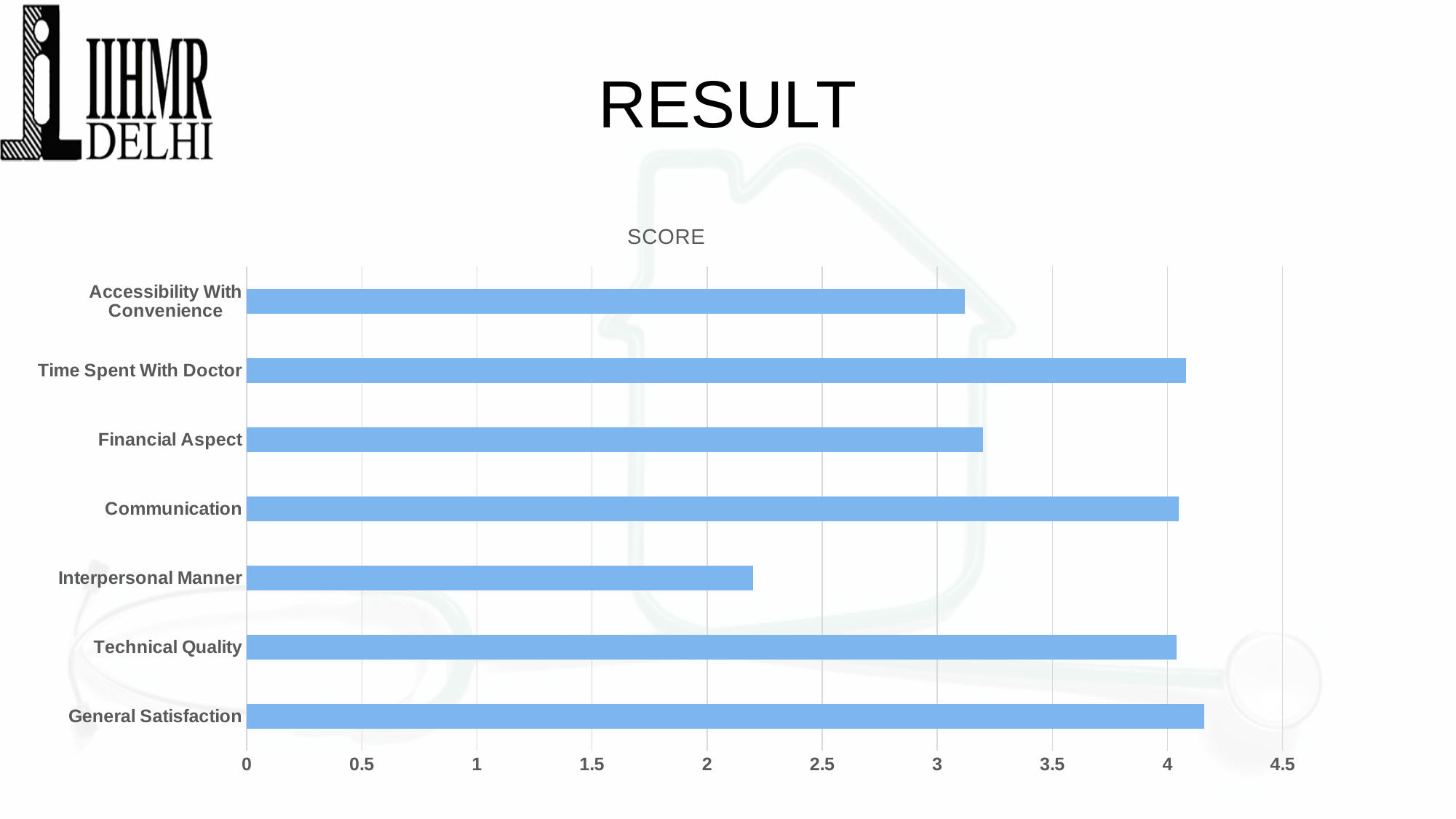
Is the value for General Satisfaction greater or less than 4? greater Is the value for Financial Aspect greater or less than 3.5? less Is the value for Accessibility With Convenience greater or less than 3.5? less Which category has the lowest score? Interpersonal Manner What is the title of the chart? SCORE Which is larger, the score for Financial Aspect or for Interpersonal Manner? Financial Aspect What kind of chart is shown on the slide? bar chart How many categories are plotted in the chart? 7 Which is larger, the score for Time Spent With Doctor or for Accessibility With Convenience? Time Spent With Doctor